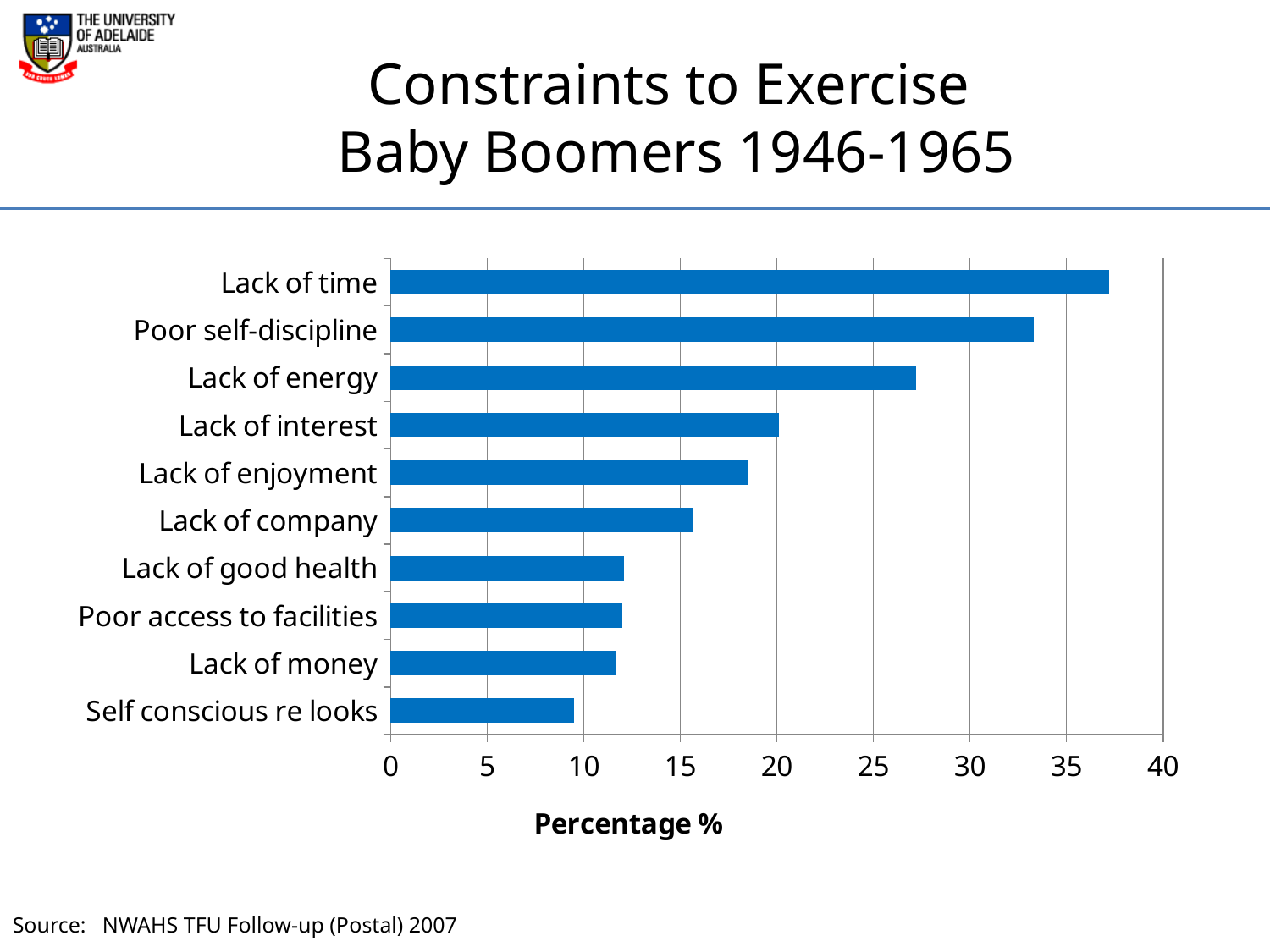
Is the value for Lack of time greater or less than 35? greater Which is larger, the value for Lack of energy or the value for Lack of interest? Lack of energy Is the value for Poor self-discipline greater or less than 30? greater How many constraints (categories) are plotted in the chart? 10 What is the label on the horizontal axis of the chart? Percentage % Which constraint has the lowest percentage? Self conscious re looks What kind of chart is shown on the slide? bar chart Which constraint has the highest percentage? Lack of time Which is larger, the value for Lack of company or the value for Lack of money? Lack of company Is the value for Lack of energy greater or less than 25? greater